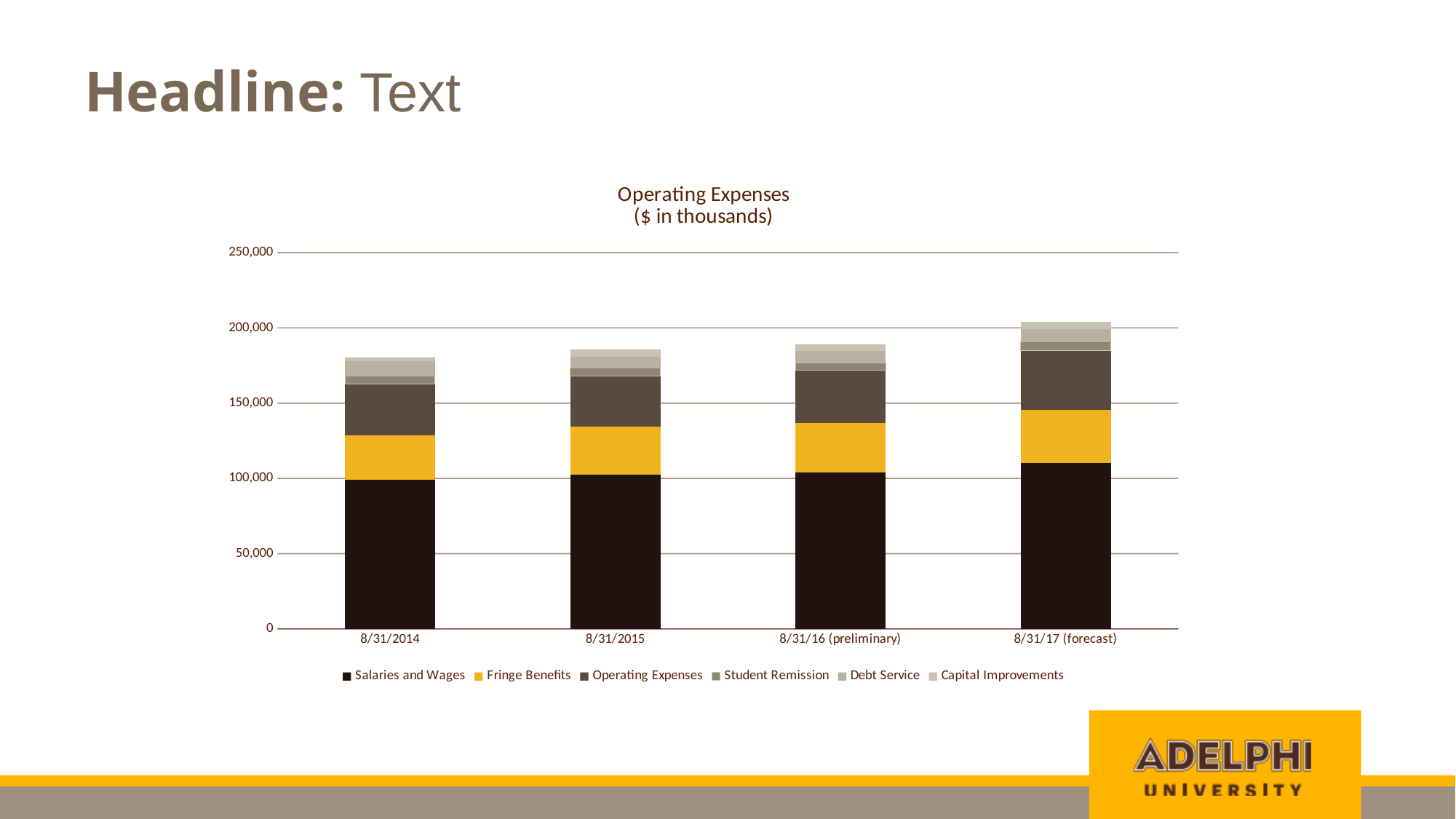
How many series does the legend list? 6 What kind of chart is shown on the slide? Stacked bar chart What is the title of the chart? Operating Expenses ($ in thousands) Which is larger, the total for 8/31/17 (forecast) or the total for 8/31/2014? 8/31/17 (forecast) Is the total bar for 8/31/16 (preliminary) greater or less than 200,000? less Do total operating expenses rise or fall from 8/31/2014 to 8/31/17 (forecast)? Rise How many date categories are shown on the x axis? 4 Is the Salaries and Wages value for 8/31/17 (forecast) greater or less than 100,000? greater Is the total bar for 8/31/2014 greater or less than 200,000? less Which date has the highest total operating expenses? 8/31/17 (forecast) Which series is shown in yellow? Fringe Benefits